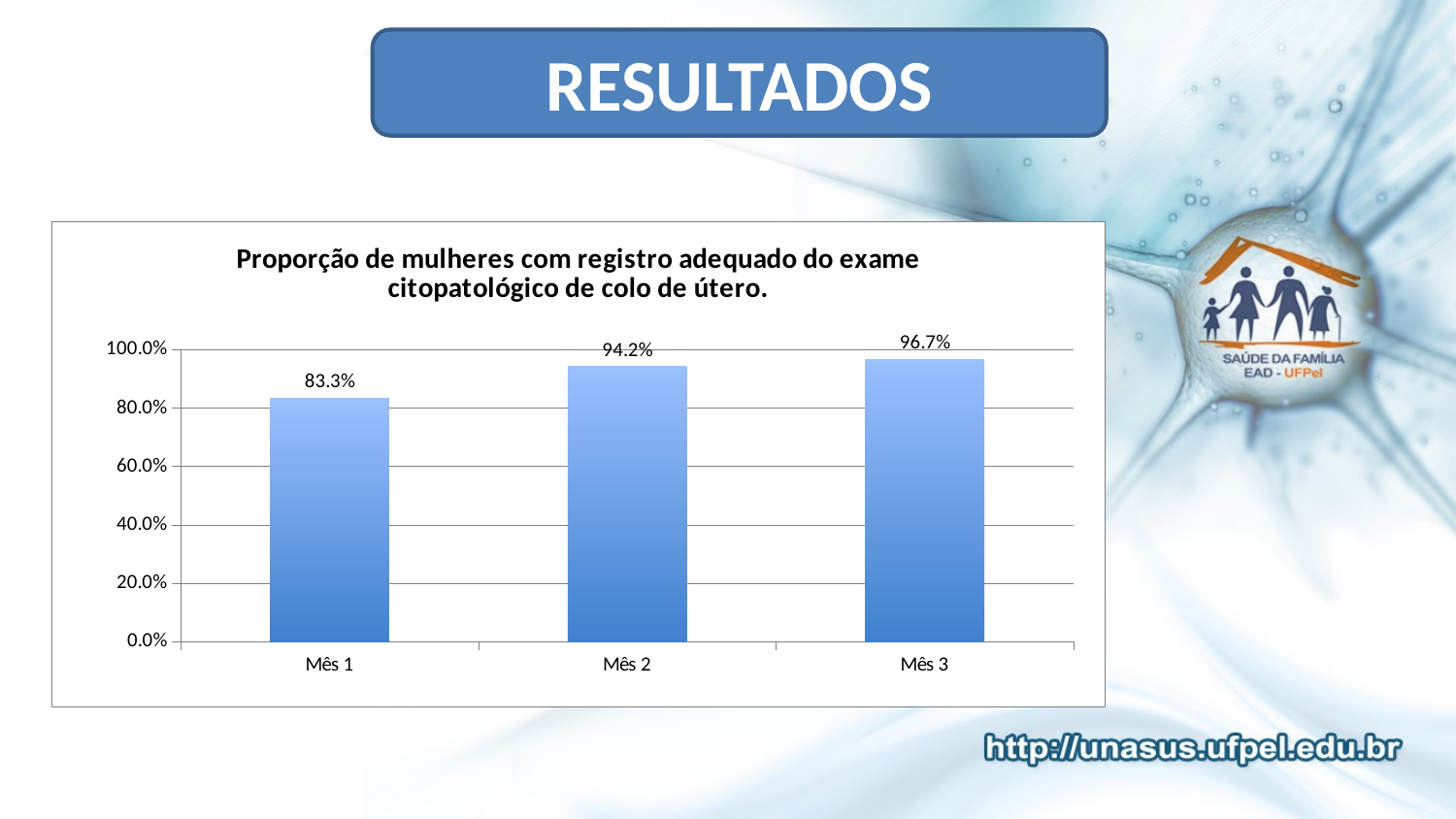
Do the values rise or fall from Mês 1 to Mês 3? Rise Which is larger, the value for Mês 1 or the value for Mês 2? Mês 2 Which month has the lowest value? Mês 1 Which month has the highest value? Mês 3 What is the difference between the values for Mês 2 and Mês 1? 10.9% Is the value for Mês 1 greater or less than 80.0%? greater What is the value for Mês 1? 83.3% What kind of chart is shown on the slide? Bar chart What is the difference between the values for Mês 3 and Mês 1? 13.4% What is the value for Mês 2? 94.2% How many months are shown on the x axis? 3 What is the value for Mês 3? 96.7%